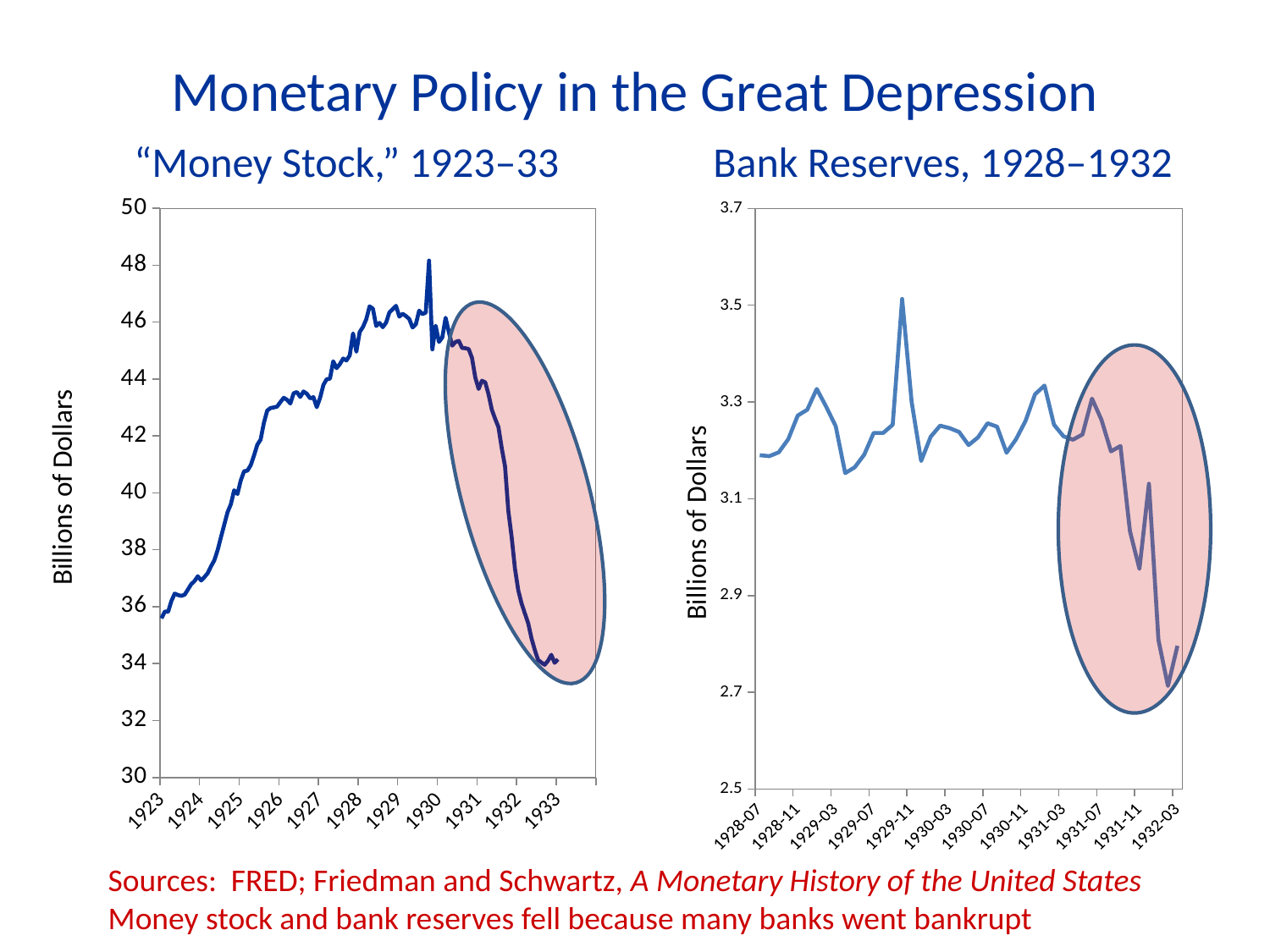
What type of chart is the "Money Stock," 1923–33 chart? line chart In the "Money Stock," 1923–33 chart, does the money stock rise or fall between 1923 and 1929? rise What is the y-axis label on the Bank Reserves, 1928–1932 chart? Billions of Dollars What type of chart is the Bank Reserves, 1928–1932 chart? line chart In the "Money Stock," 1923–33 chart, is the highest point of the line greater or less than 46? greater In the "Money Stock," 1923–33 chart, is the value at the start of 1923 greater or less than 38? less In the "Money Stock," 1923–33 chart, which is larger: the value in 1929 or the value in 1933? 1929 In the Bank Reserves, 1928–1932 chart, is the lowest point of the line greater or less than 2.9? less In the "Money Stock," 1923–33 chart, does the money stock rise or fall between 1930 and 1933? fall